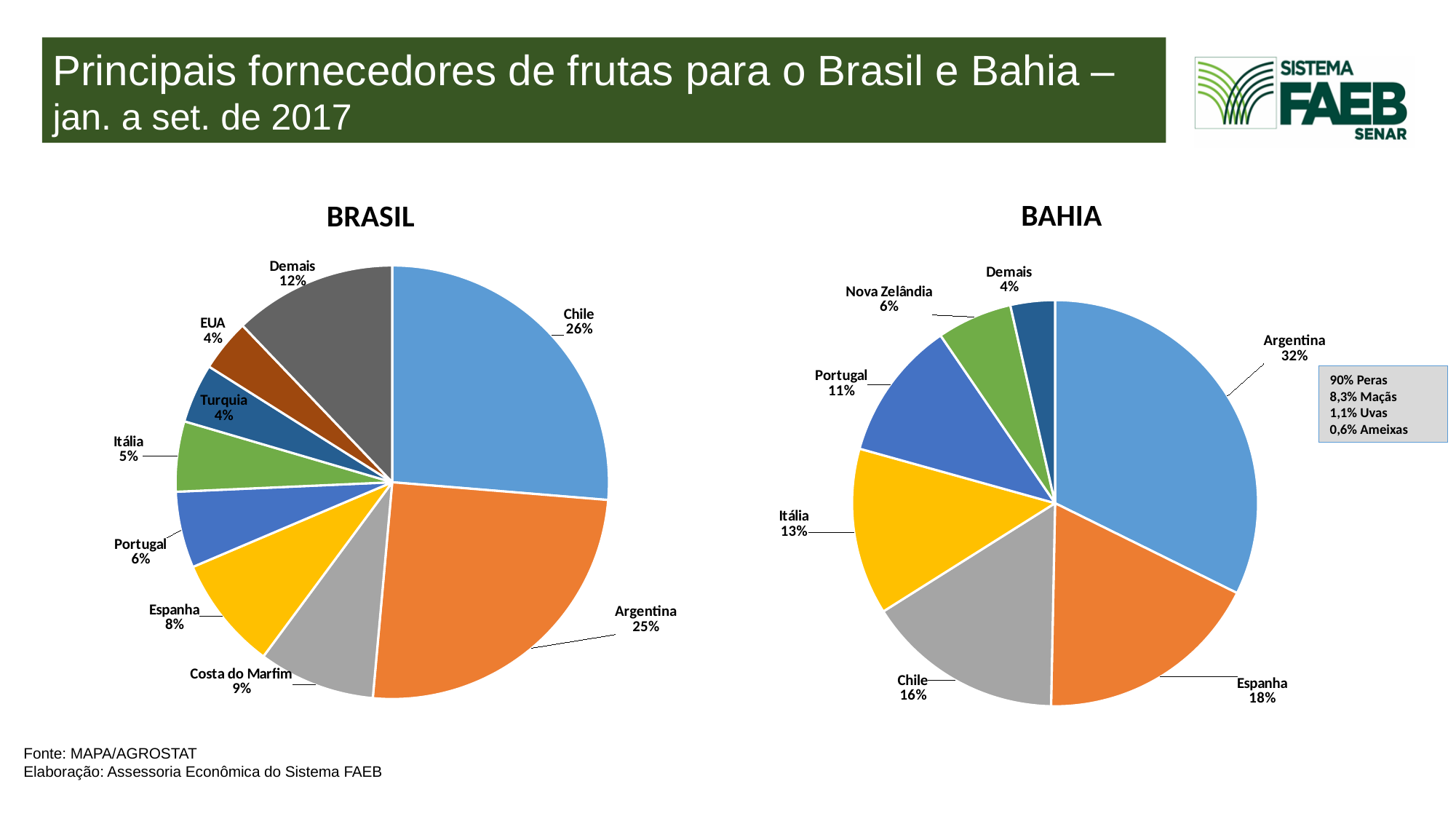
How many slices does the BRASIL pie chart have? 9 In the BAHIA chart, which supplier has the largest share? Argentina Which is larger in the BRASIL chart: the share of Espanha or the share of Portugal? Espanha In the BAHIA chart, what share does Argentina have? 32% In the BAHIA chart, what is the difference between the shares of Espanha and Chile? 2% In the BRASIL chart, what share does Chile have? 26% What type of chart is used for the BAHIA data? Pie chart In the BAHIA chart, what share does Nova Zelândia have? 6% In the BRASIL chart, what is the difference between the shares of Chile and Argentina? 1% In the BRASIL chart, what share does Costa do Marfim have? 9% In the BAHIA chart, which category has the smallest share? Demais How many slices does the BAHIA pie chart have? 7